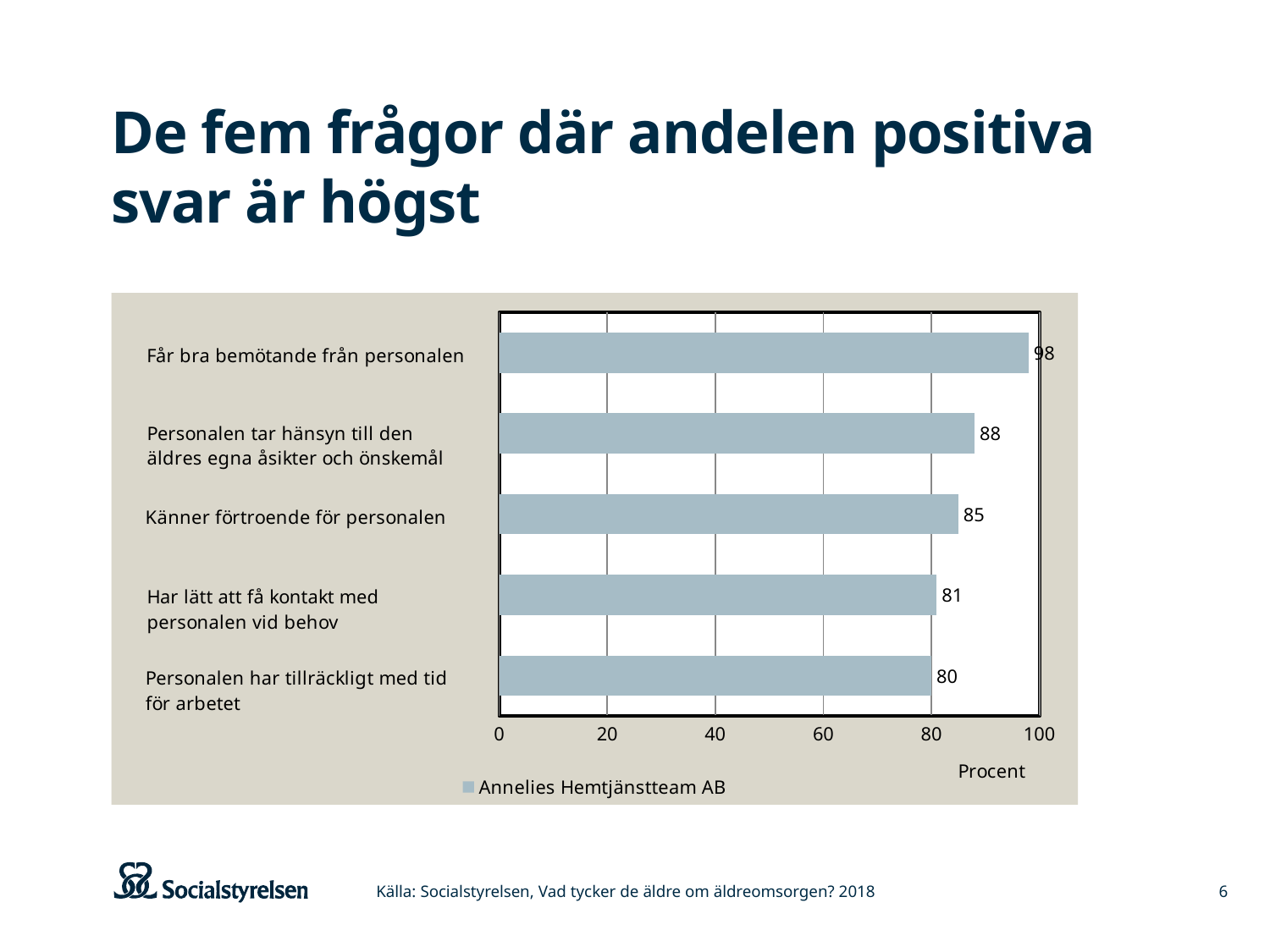
Which is larger, the value for "Känner förtroende för personalen" or the value for "Har lätt att få kontakt med personalen vid behov"? Känner förtroende för personalen Which category has the highest value? Får bra bemötande från personalen Which category has the lowest value? Personalen har tillräckligt med tid för arbetet What is the value for "Får bra bemötande från personalen"? 98 How many categories are shown in the chart? 5 What kind of chart is shown on the slide? Bar chart What is the difference between the values for "Får bra bemötande från personalen" and "Personalen tar hänsyn till den äldres egna åsikter och önskemål"? 10 Is the value for "Personalen tar hänsyn till den äldres egna åsikter och önskemål" greater or less than 80? greater What is the name of the series shown in the legend? Annelies Hemtjänstteam AB What is the value for "Personalen har tillräckligt med tid för arbetet"? 80 How many series does the legend list? 1 What is the value for "Känner förtroende för personalen"? 85